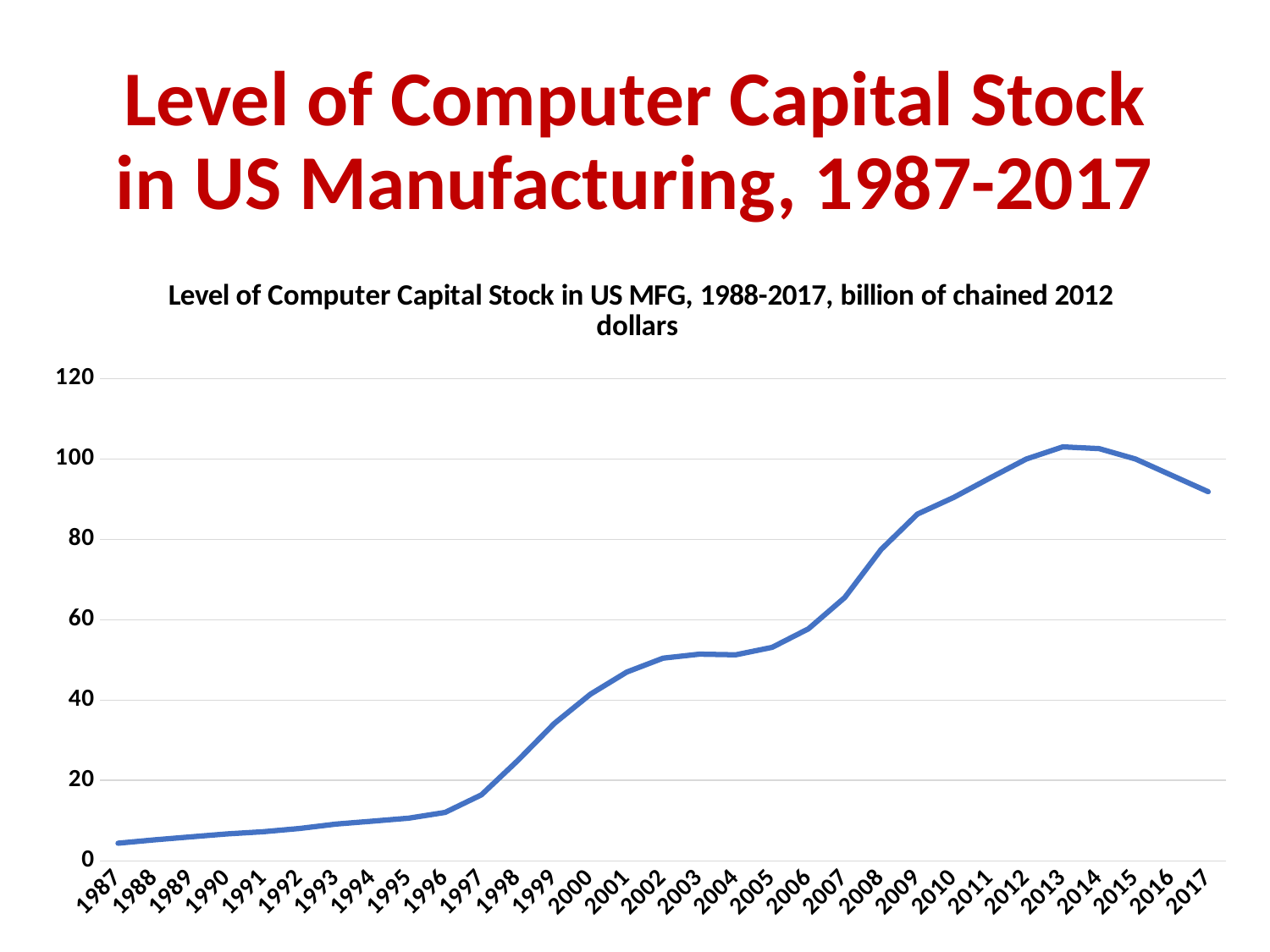
Is the value for 2011 greater or less than 80? greater Is the value for 2005 greater or less than 60? less Which year has the lowest level of computer capital stock? 1987 Is the value for 2017 greater or less than 80? greater Do the values rise or fall from 2013 to 2017? fall Which year has the larger value, 1997 or 2000? 2000 What kind of chart is shown on the slide? Line chart How many years are plotted along the x axis? 31 In what units are the values on the chart expressed, according to the chart title? billion of chained 2012 dollars Which year has the larger value, 2013 or 2017? 2013